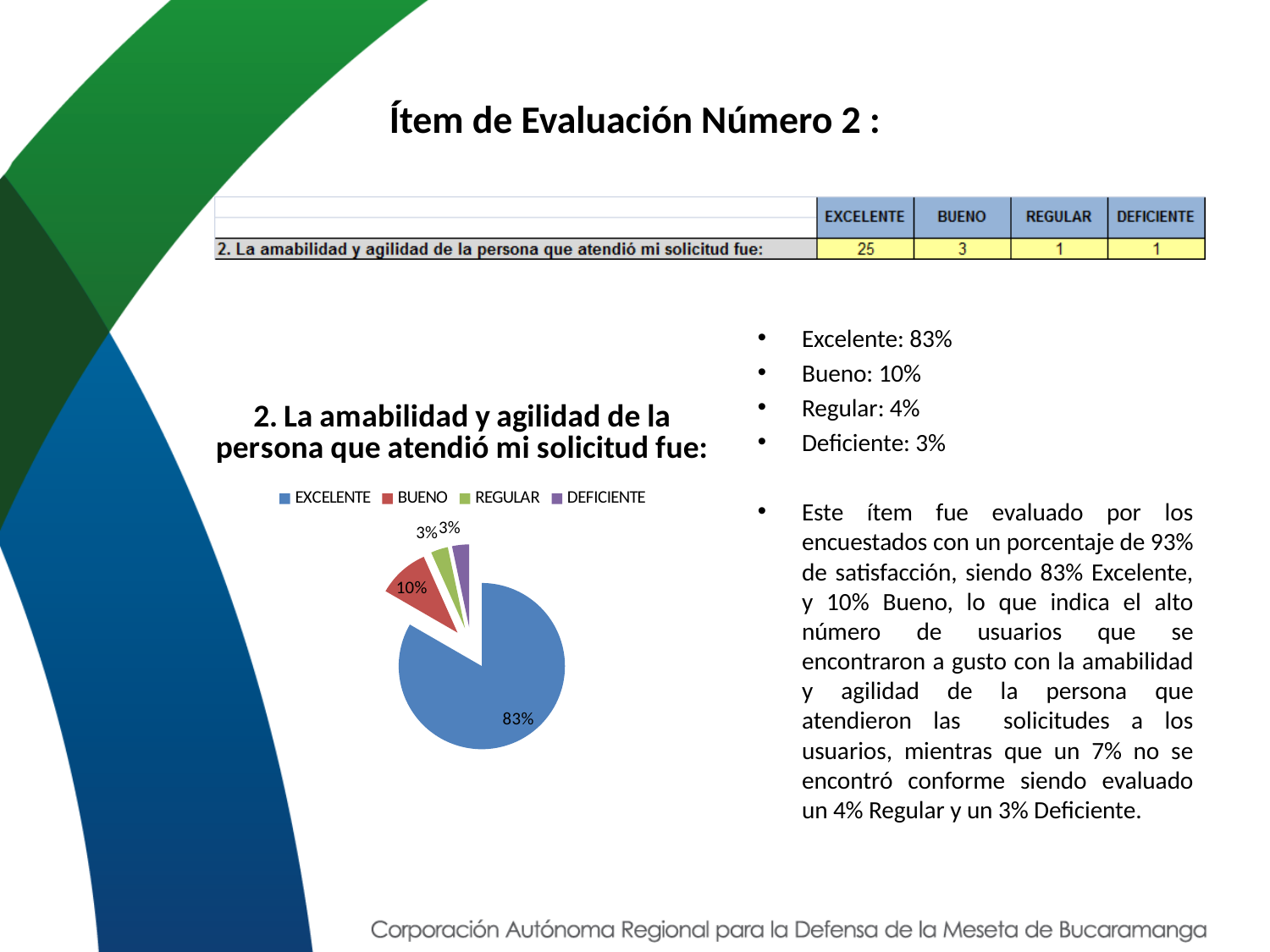
What colour is the EXCELENTE slice in the pie chart? blue What is the title of the pie chart? 2. La amabilidad y agilidad de la persona que atendió mi solicitud fue: What percentage is shown for BUENO in the pie chart? 10% Which slice is larger in the pie chart, BUENO or REGULAR? BUENO How many slices does the pie chart have? 4 What is the difference in percentage points between the EXCELENTE and BUENO slices? 73% Which category has the largest slice in the pie chart? EXCELENTE What kind of chart is shown on the slide? pie chart What percentage is shown for EXCELENTE in the pie chart? 83% What percentage is shown for DEFICIENTE in the pie chart? 3% What percentage is shown for REGULAR in the pie chart? 3% How many entries does the legend of the pie chart list? 4